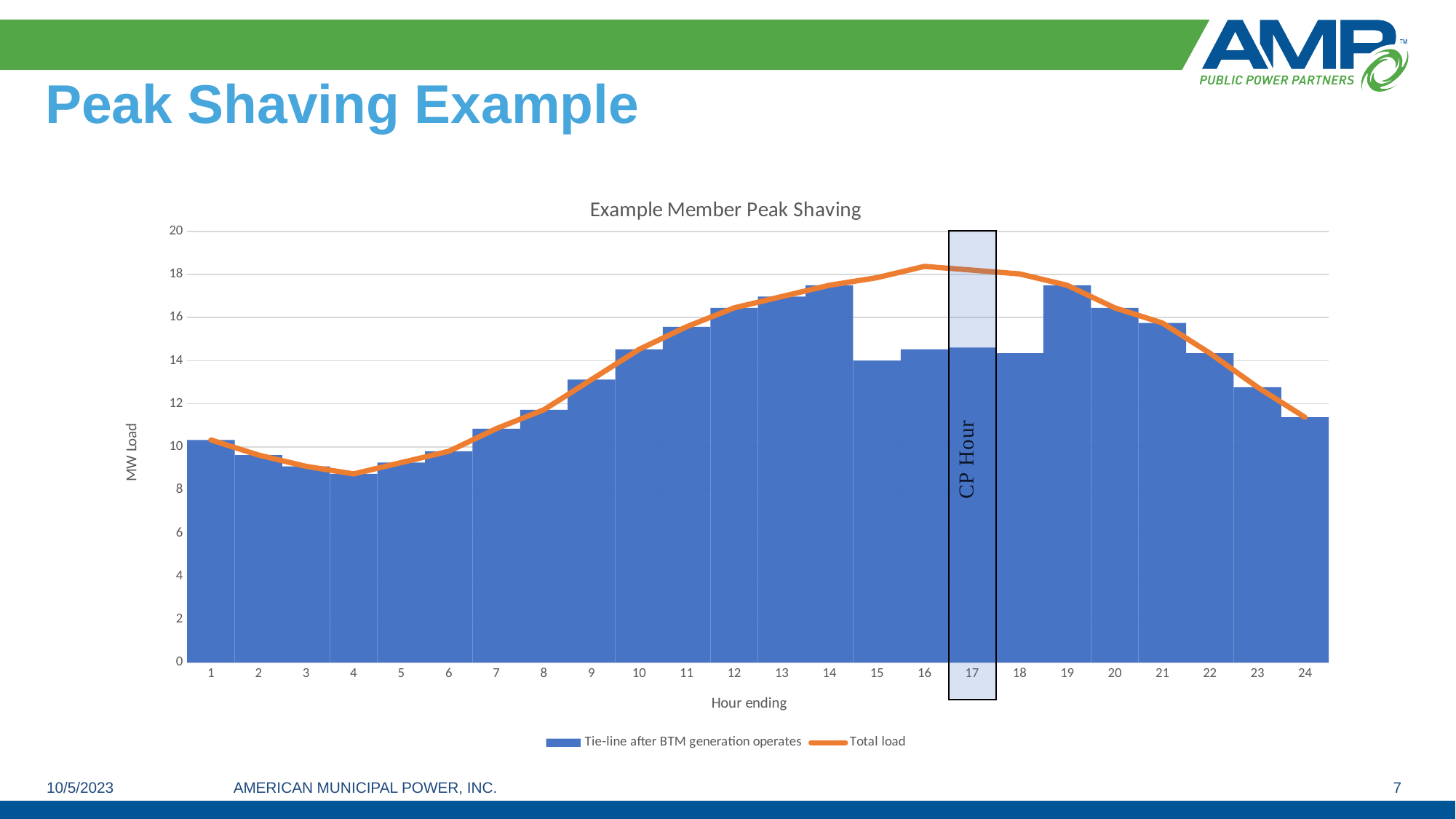
Which is larger, the Tie-line after BTM generation operates bar at hour 12 or at hour 15? Hour 12 Which hour is marked as the CP Hour on the chart? 17 Is the Tie-line after BTM generation operates value at hour 4 greater or less than 10? less Do the Tie-line after BTM generation operates bars rise or fall from hour 4 to hour 14? Rise What kind of chart is shown on the slide? A combined bar and line chart How many hours (categories) are plotted along the x axis? 24 What are the two series named in the legend? Tie-line after BTM generation operates; Total load Is the Tie-line after BTM generation operates value at hour 15 greater or less than 16? less How many series does the legend list? 2 At which hour does the Total load line reach its highest point? 16 Is the Tie-line after BTM generation operates value at hour 14 greater or less than 16? greater At which hour is the Tie-line after BTM generation operates bar lowest? 4